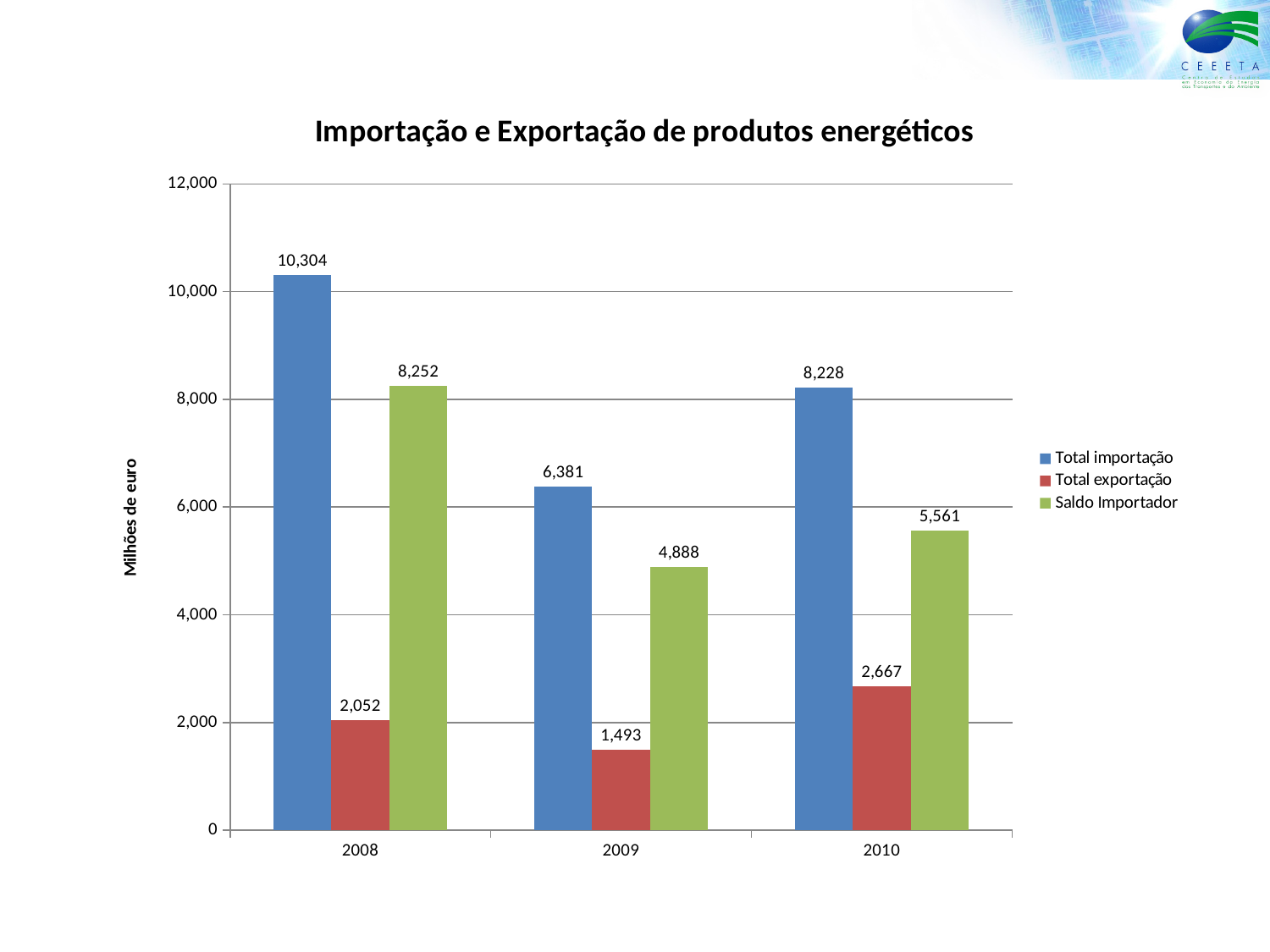
What kind of chart is shown? Bar chart What is the label of the vertical axis? Milhões de euro What is the difference between Total importação and Total exportação in 2010? 5,561 How many years are shown on the x axis? 3 In which year is Total importação highest? 2008 What is the value of Saldo Importador in 2010? 5,561 Is the value for Total exportação in 2010 greater or less than 2,000? greater How many series does the legend list? 3 In which year is Total exportação lowest? 2009 What is the value of Total importação in 2008? 10,304 Which is larger: Saldo Importador in 2008 or Total importação in 2010? Saldo Importador in 2008 What is the value of Total exportação in 2009? 1,493